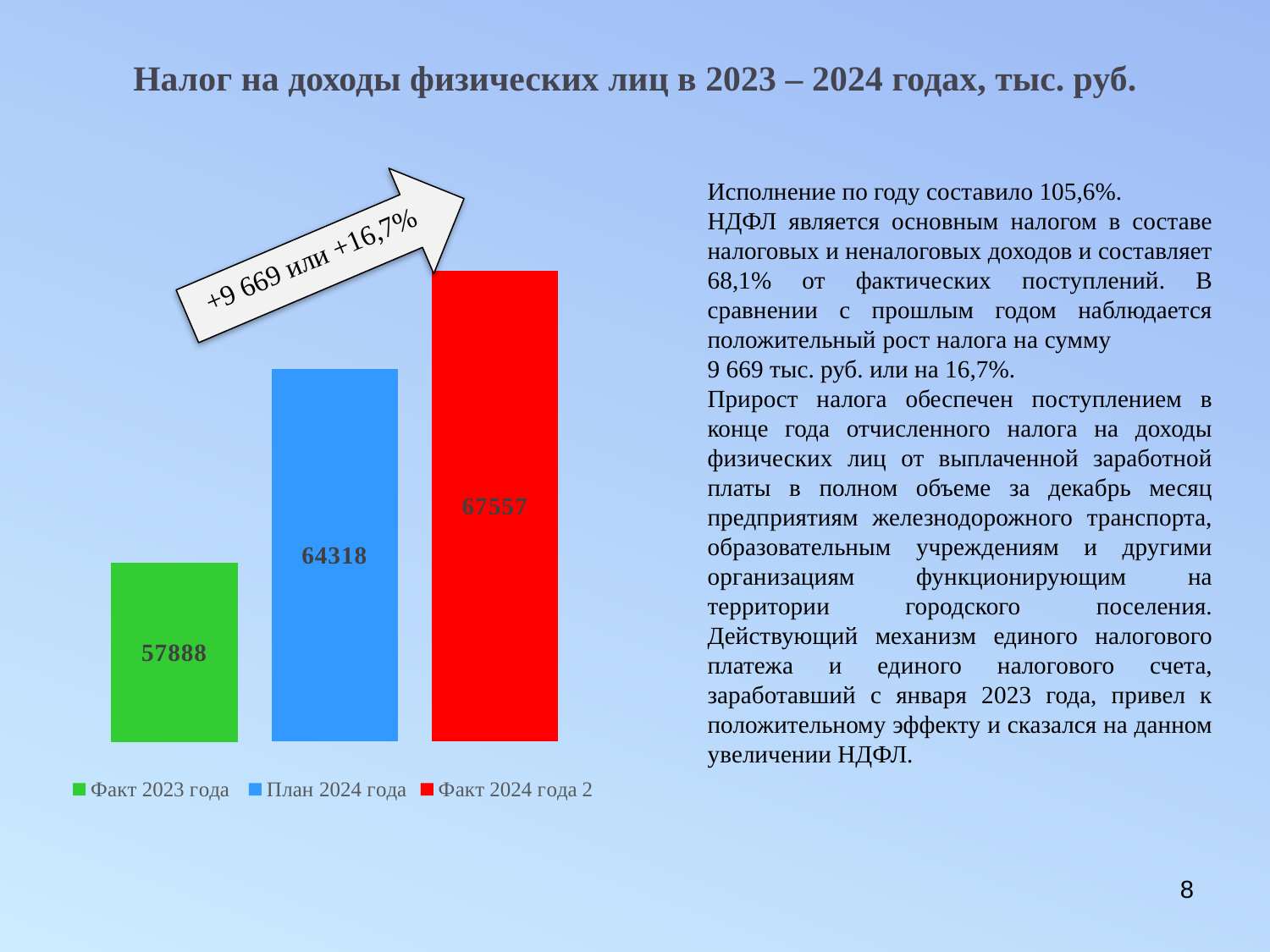
Which series has the lowest value? Факт 2023 года What is the difference between Факт 2024 года 2 and Факт 2023 года? 9669 What colour is the bar for План 2024 года? Blue What is the value for Факт 2023 года? 57888 What is the difference between Факт 2024 года 2 and План 2024 года? 3239 What is the value for План 2024 года? 64318 Which series has the highest value? Факт 2024 года 2 Which is larger, План 2024 года or Факт 2023 года? План 2024 года How many series does the legend list? 3 What kind of chart is shown on the slide? Bar chart How many bars are plotted on the chart? 3 What is the value for Факт 2024 года 2? 67557